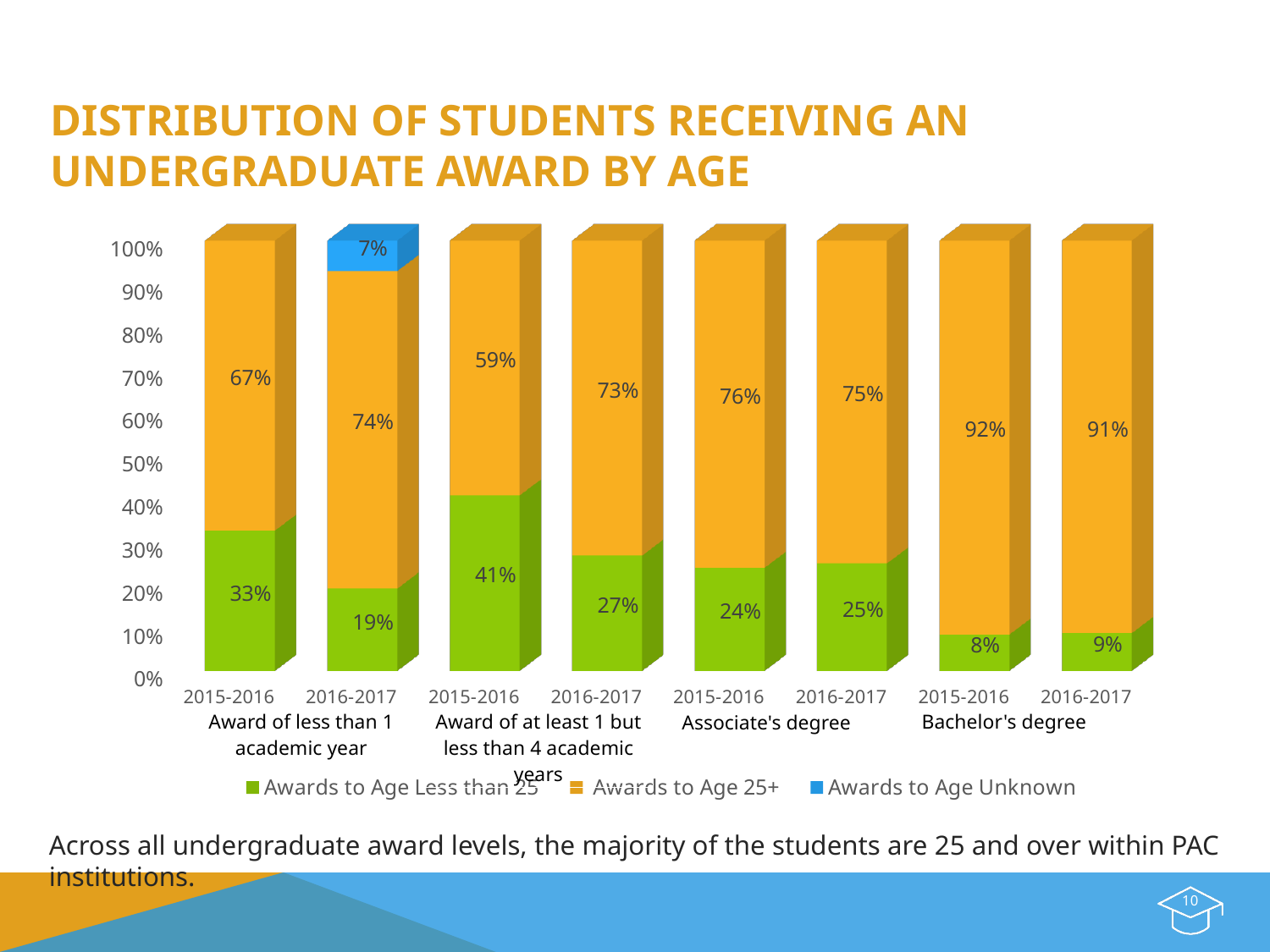
Which bar has the highest percentage of awards to students aged 25+? Bachelor's degree, 2015-2016 What is the combined share of 'Awards to Age Less than 25' and 'Awards to Age 25+' for awards of less than 1 academic year in 2016-2017? 93% What is the difference between the 'Awards to Age Less than 25' share for awards of at least 1 but less than 4 academic years in 2015-2016 and in 2016-2017? 14 percentage points For associate's degrees, is the 'Awards to Age 25+' share larger in 2015-2016 or 2016-2017? 2015-2016 Which series is shown in blue in the legend? Awards to Age Unknown What share of awards of less than 1 academic year in 2016-2017 went to students of unknown age? 7% How many series does the legend list? 3 What percentage of bachelor's degree awards in 2016-2017 went to students aged less than 25? 9% What type of chart is shown on the slide? Stacked bar chart Which bar has the lowest percentage of awards to students aged less than 25? Bachelor's degree, 2015-2016 What percentage of awards of less than 1 academic year in 2015-2016 went to students aged 25+? 67% How many bars are shown in the chart? 8